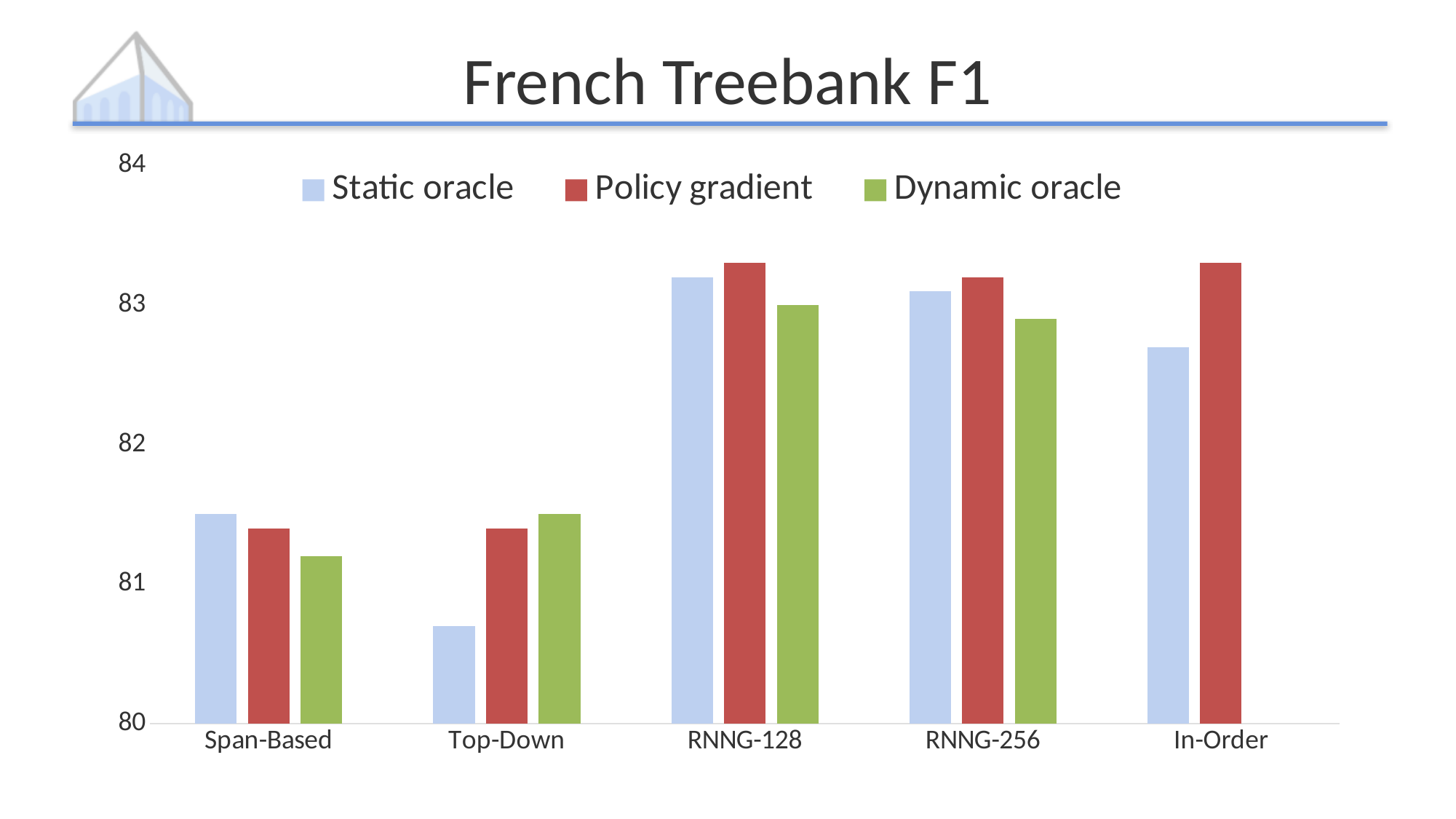
What kind of chart is shown on the slide? bar chart Is the Static oracle value for Top-Down greater or less than 81? less Which has the larger Static oracle value, Span-Based or Top-Down? Span-Based Which category has the lowest Static oracle value? Top-Down Is the Dynamic oracle value for RNNG-256 greater or less than 83? less How many series does the legend list? 3 Which category has no Dynamic oracle bar? In-Order Is the Static oracle value for In-Order greater or less than 83? less What is the title of the chart? French Treebank F1 For In-Order, which is larger, the Static oracle value or the Policy gradient value? Policy gradient How many parser categories are shown on the x axis? 5